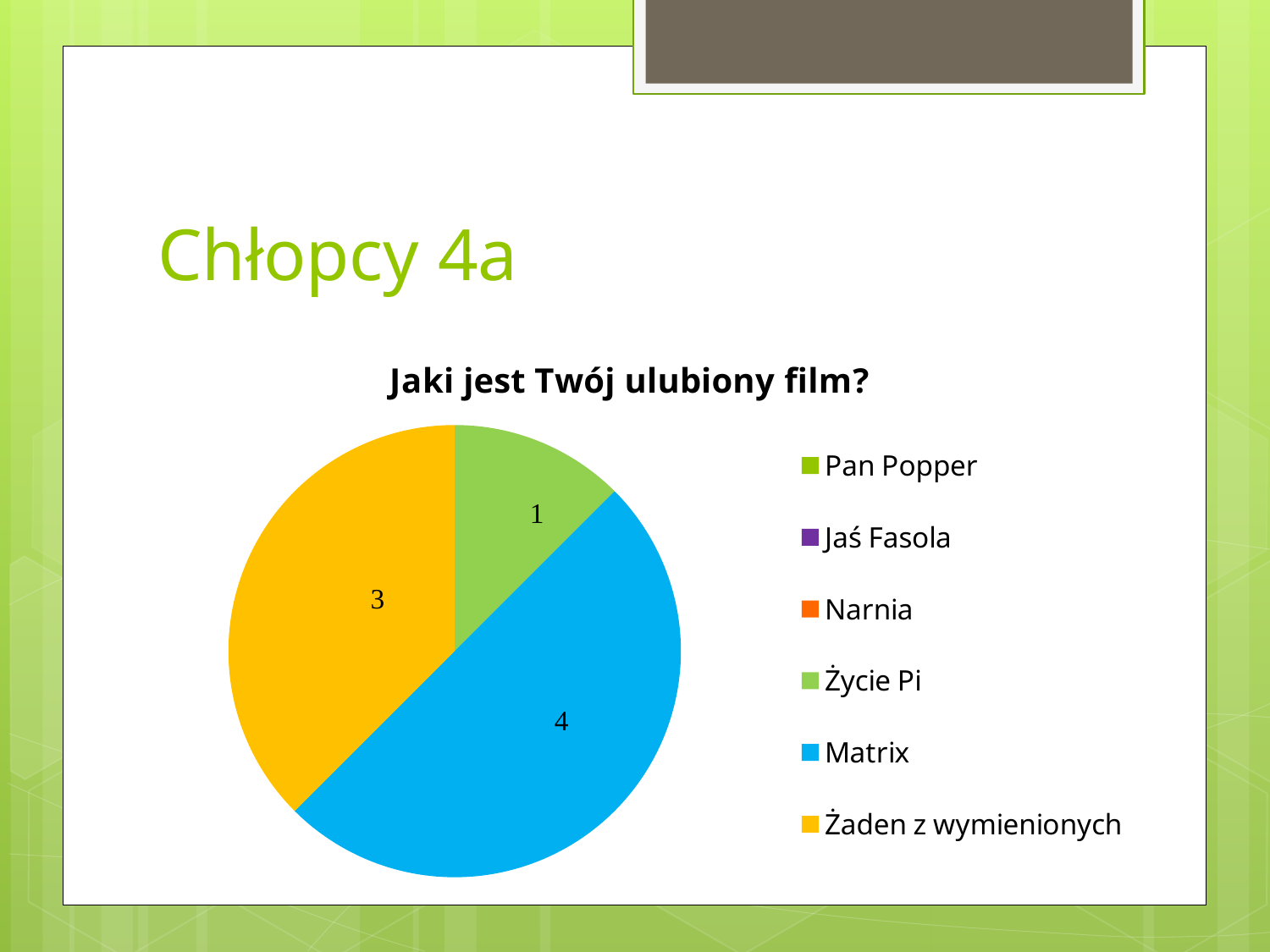
What is the title of the chart? Jaki jest Twój ulubiony film? What is the value for Żaden z wymienionych? 3 What is the smallest value labelled on the pie? 1 What is the value for Matrix? 4 What is the difference between the values for Matrix and Żaden z wymienionych? 1 What type of chart is shown on the slide? pie chart How many slices with data labels are visible on the pie? 3 Which category has the largest slice of the pie? Matrix How many entries does the chart legend list? 6 What share of the pie does Matrix represent? 50% Which is larger, the value for Matrix or the value for Żaden z wymienionych? Matrix What is the total of all values labelled on the pie? 8